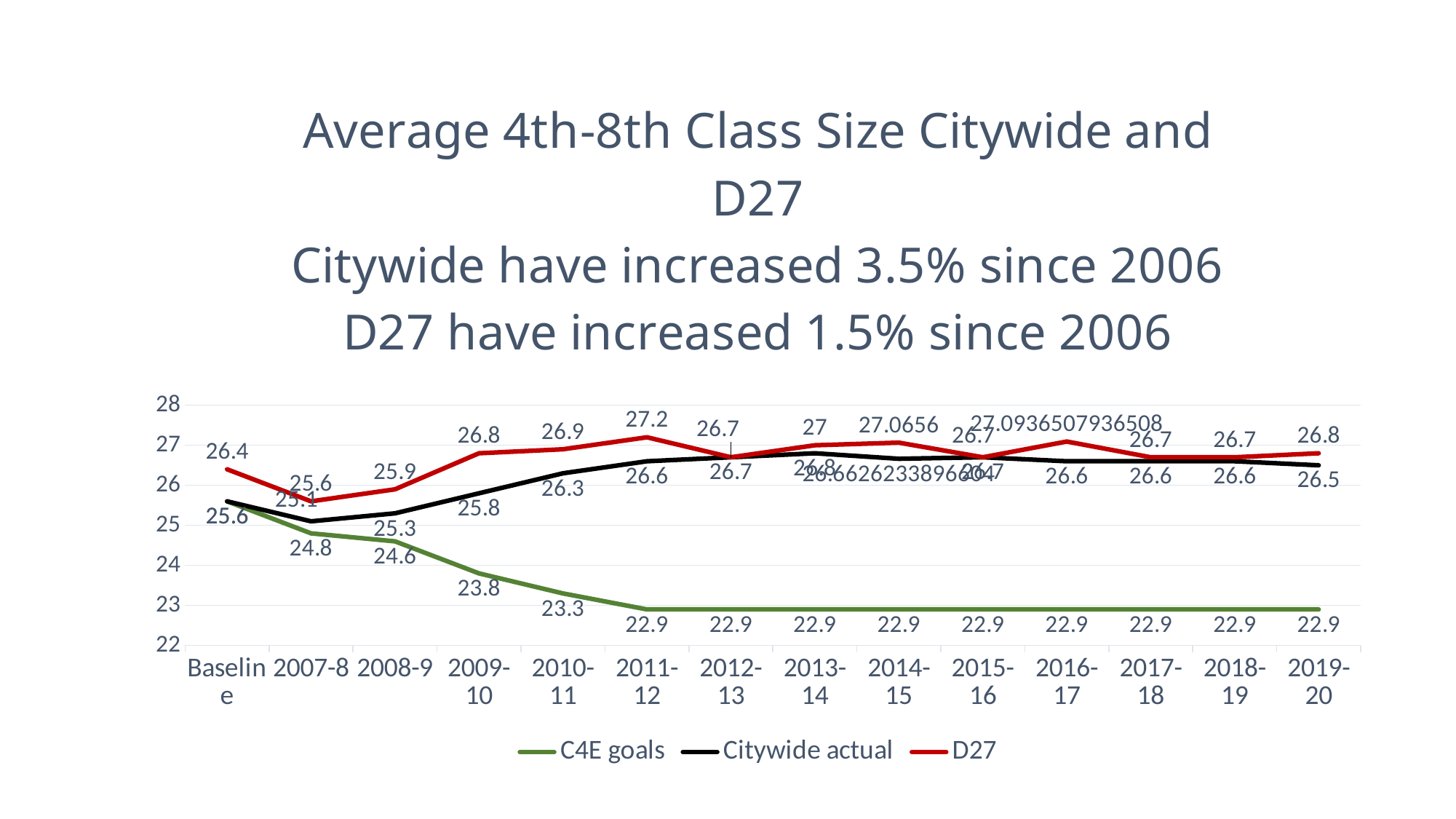
How many series does the legend list? 3 What is the D27 value for 2011-12? 27.2 Do the C4E goals values rise or fall from Baseline to 2011-12? fall Which is larger for 2009-10, the D27 value or the Citywide actual value? D27 In which category is the Citywide actual value lowest? 2007-8 What is the C4E goals value for 2010-11? 23.3 What is the Citywide actual value for 2007-8? 25.1 How many categories are shown along the x axis? 14 What is the D27 value at Baseline? 26.4 What is the difference between the D27 value and the Citywide actual value for 2011-12? 0.6 What colour is the D27 line in the legend? red What kind of chart is shown on the slide? line chart